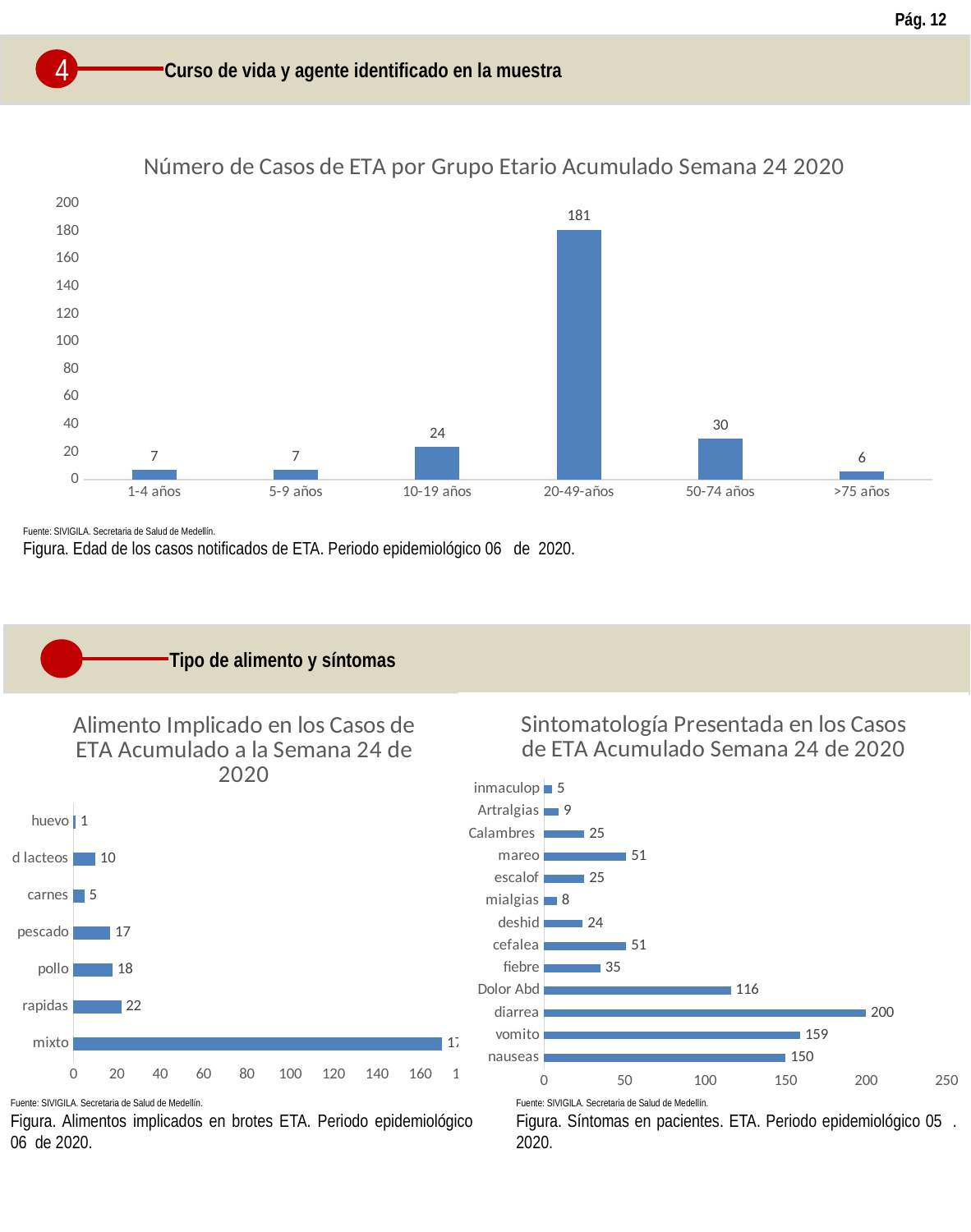
In the chart 'Sintomatología Presentada en los Casos de ETA Acumulado Semana 24 de 2020', which is larger: Dolor Abd or fiebre? Dolor Abd In the chart 'Sintomatología Presentada en los Casos de ETA Acumulado Semana 24 de 2020', what is the value for vomito? 159 In the chart 'Alimento Implicado en los Casos de ETA Acumulado a la Semana 24 de 2020', what is the value for rapidas? 22 In the chart 'Alimento Implicado en los Casos de ETA Acumulado a la Semana 24 de 2020', is the value for mixto greater or less than 160? greater In the chart 'Número de Casos de ETA por Grupo Etario Acumulado Semana 24 2020', how many cases are in the 20-49-años group? 181 In the chart 'Alimento Implicado en los Casos de ETA Acumulado a la Semana 24 de 2020', which food has the lowest value? huevo In the chart 'Número de Casos de ETA por Grupo Etario Acumulado Semana 24 2020', which age group has the lowest number of cases? >75 años How many symptoms are listed in the chart 'Sintomatología Presentada en los Casos de ETA Acumulado Semana 24 de 2020'? 13 What type of chart is 'Número de Casos de ETA por Grupo Etario Acumulado Semana 24 2020'? Bar chart How many age groups are shown in the chart 'Número de Casos de ETA por Grupo Etario Acumulado Semana 24 2020'? 6 In the chart 'Número de Casos de ETA por Grupo Etario Acumulado Semana 24 2020', what is the difference between the 50-74 años and 10-19 años groups? 6 In the chart 'Sintomatología Presentada en los Casos de ETA Acumulado Semana 24 de 2020', which symptom has the highest value? diarrea